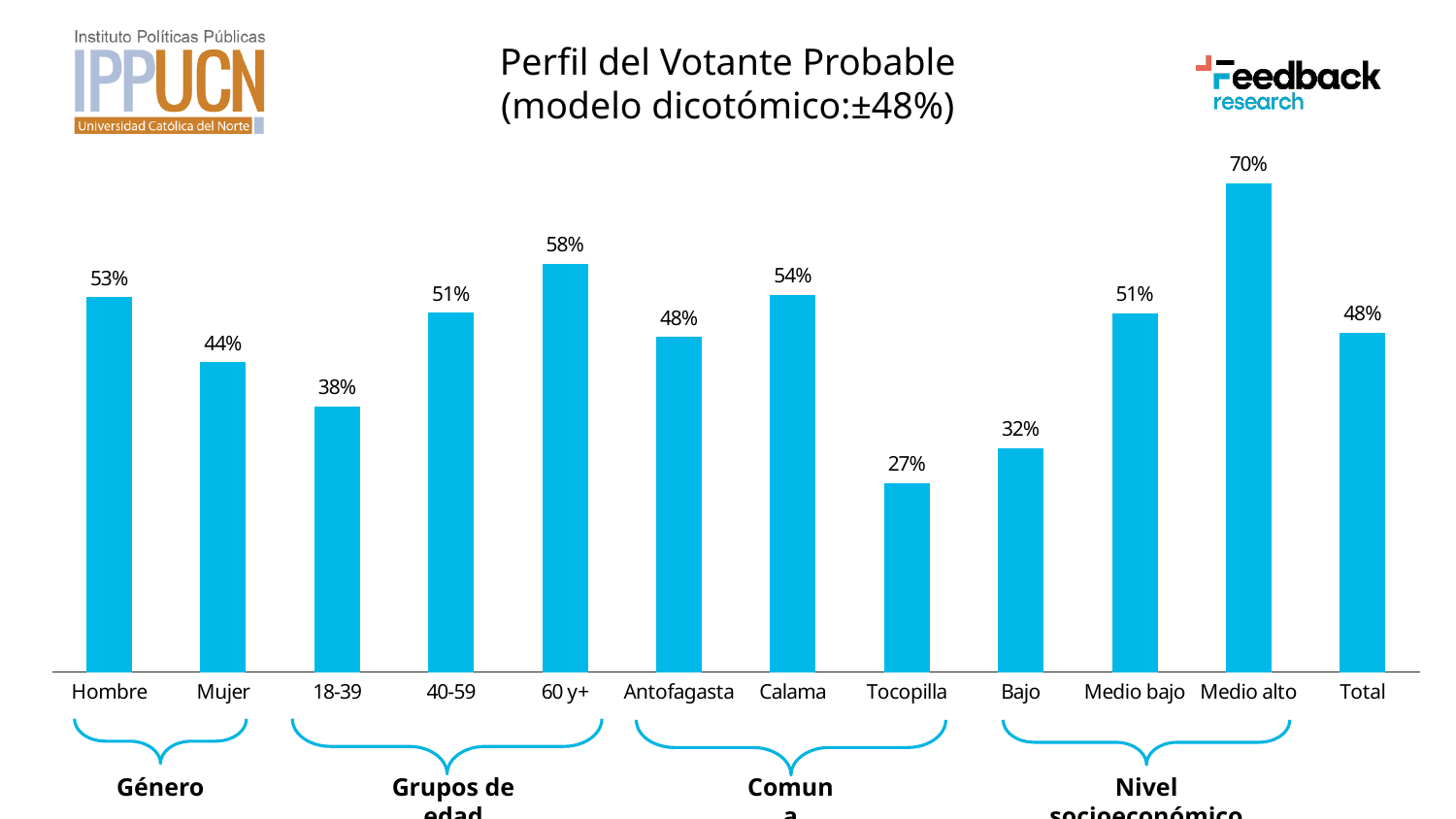
What is the difference between the values for Hombre and Mujer? 9% What is the value for Hombre? 53% Which category has the lowest value? Tocopilla What is the value for Total? 48% How many bars are shown in the chart? 12 Do the values rise or fall across the age groups from 18-39 to 60 y+? Rise Which category has the highest value? Medio alto What is the value for Tocopilla? 27% What is the difference between the values for 60 y+ and 18-39? 20% What is the value for Medio alto? 70% Which is larger, the value for Calama or the value for Antofagasta? Calama What kind of chart is shown on the slide? Bar chart